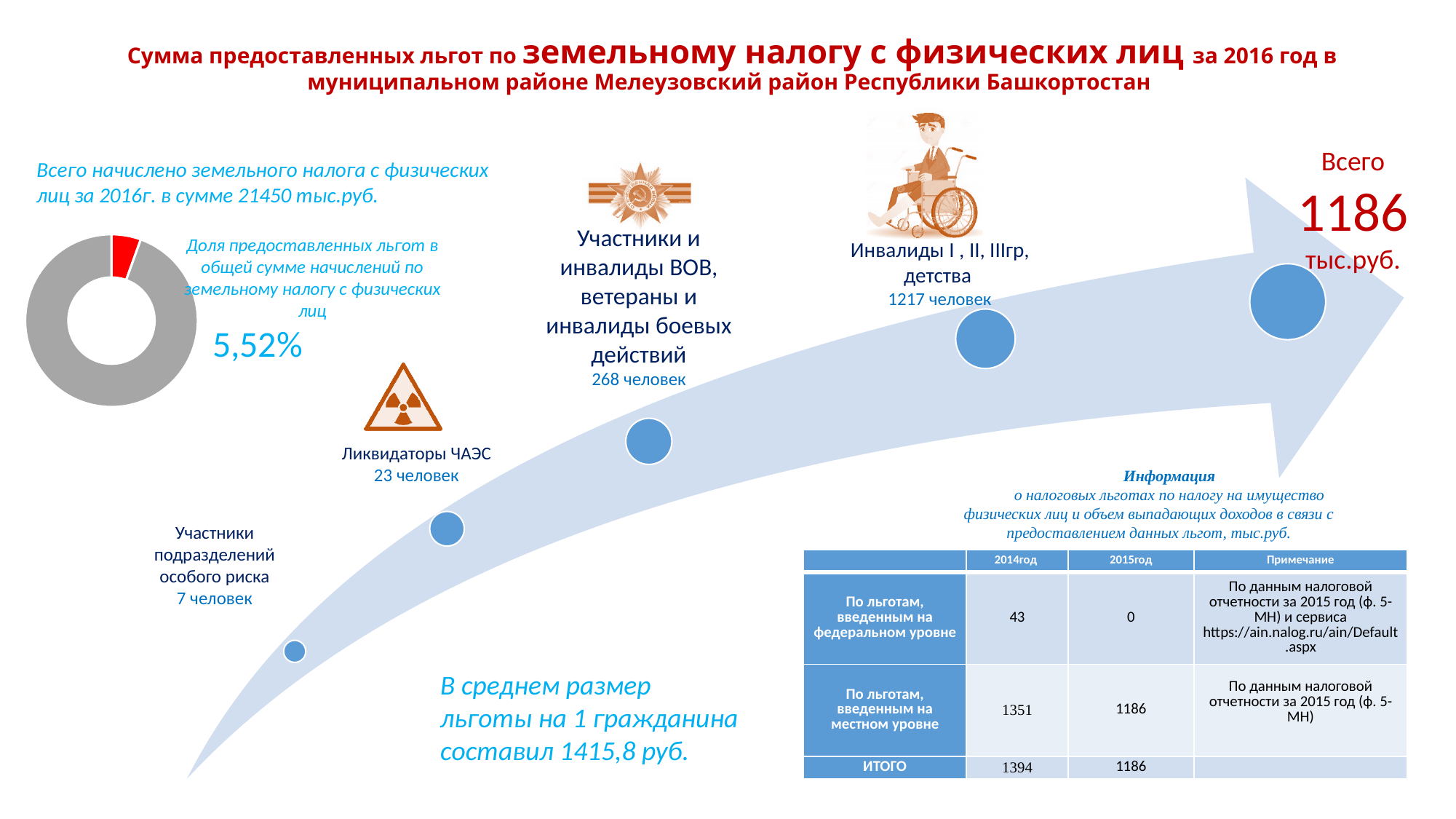
How many slices does the donut chart have? 2 In the donut chart, is the share of provided benefits greater or less than 10%? less In the donut chart, what share of total land tax accruals do the provided benefits represent? 5,52% What colour is the slice of the donut chart that represents the share of provided benefits? Red What does the red slice of the donut chart represent, according to the label next to it? Доля предоставленных льгот в общей сумме начислений по земельному налогу с физических лиц In the donut chart, which slice is the smallest? The red slice (5,52%) In the donut chart, which slice is larger, the red one or the grey one? The grey one What kind of chart is shown on the left of the slide below the text about total accrued land tax? Pie (donut) chart